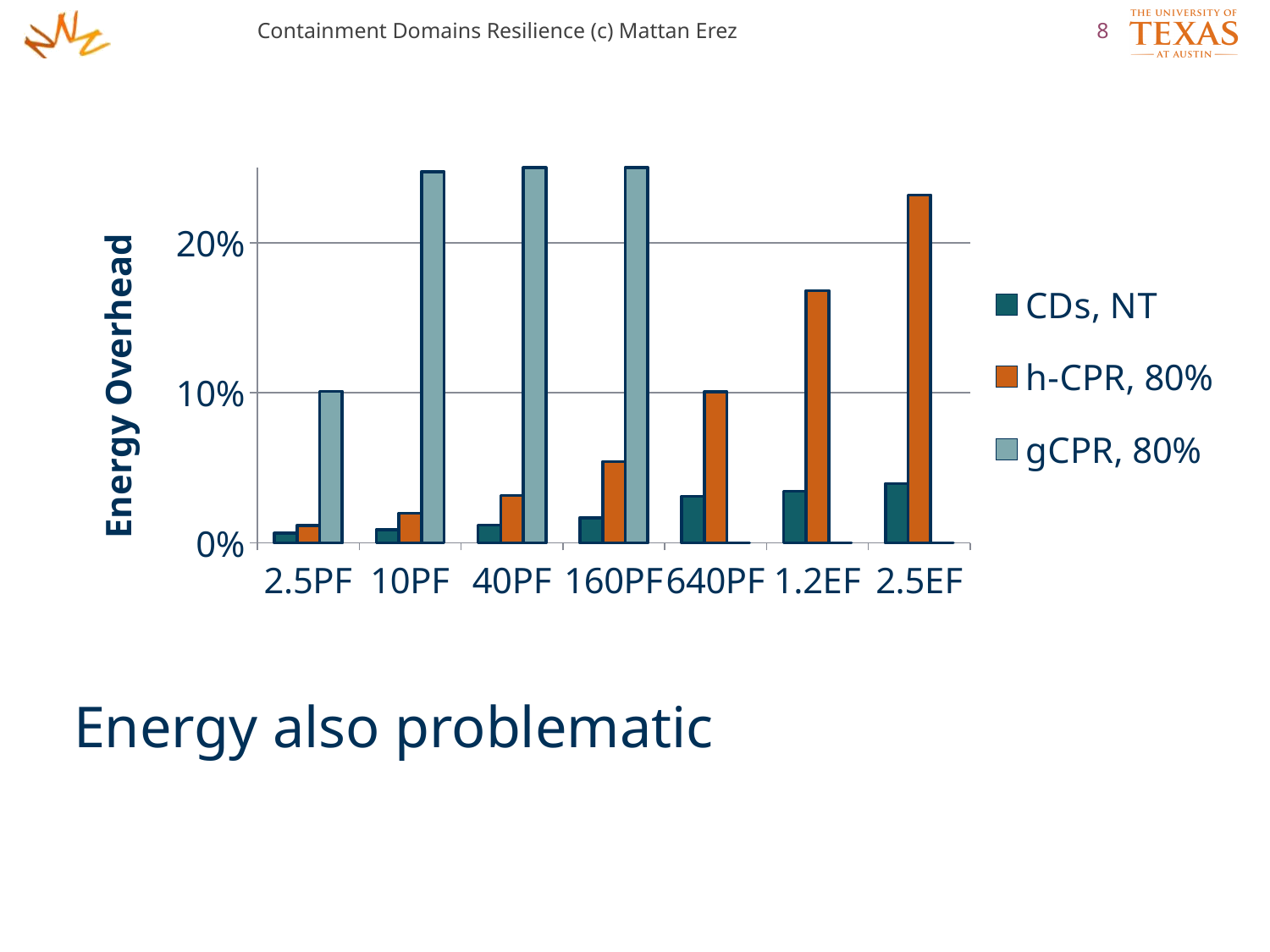
How many categories are shown on the x axis? 7 For the h-CPR, 80% series, which category has the highest value? 2.5EF At 10PF, which is larger: gCPR, 80% or h-CPR, 80%? gCPR, 80% Is the value for h-CPR, 80% at 2.5EF greater or less than 20%? greater What is the title of the vertical axis? Energy Overhead Is the value for gCPR, 80% at 10PF greater or less than 20%? greater Is the value for CDs, NT at 2.5EF greater or less than 10%? less Do the values for the CDs, NT series rise or fall from 2.5PF to 2.5EF? rise How many series does the legend list? 3 What kind of chart is shown on the slide? bar chart Which series is shown in orange in the legend? h-CPR, 80%